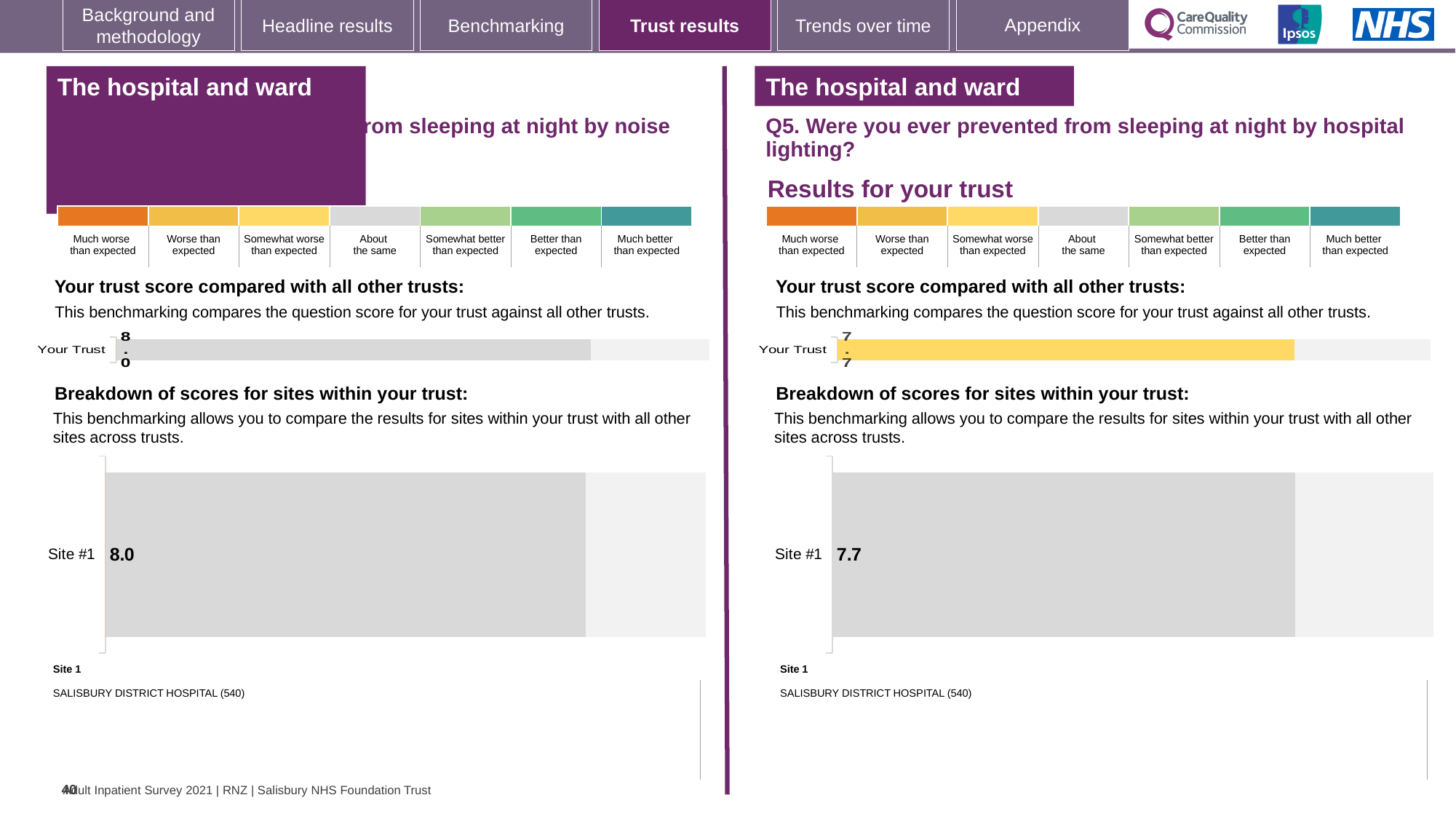
What is the difference between the Site #1 score on the left-hand chart (8.0) and the Site #1 score on the right-hand chart (7.7)? 0.3 Which hospital is listed as Site 1 beneath the site breakdown chart on the right-hand side (Q5, hospital lighting)? SALISBURY DISTRICT HOSPITAL (540) Which is larger: the Your Trust score on the left-hand chart (noise) or the Your Trust score on the right-hand chart (Q5, hospital lighting)? Left-hand chart (noise), 8.0 On the left-hand chart (sleeping at night by noise), what is the score shown for Your Trust? 8.0 On the right-hand site breakdown chart (Q5, hospital lighting), what is the score for Site #1? 7.7 How many sites are shown in the site breakdown chart on the right-hand side (Q5, hospital lighting)? 1 On the left-hand site breakdown chart (sleeping at night by noise), what is the score for Site #1? 8.0 On the right-hand chart (Q5, hospital lighting), what colour is the Your Trust bar? Yellow What kind of chart is used to show the Your Trust score on the right-hand side (Q5, hospital lighting)? Bar chart On the right-hand chart (Q5, hospital lighting), what is the score shown for Your Trust? 7.7 On the right-hand chart (Q5, hospital lighting), which benchmark category does the yellow colour of the Your Trust bar correspond to in the key? Somewhat worse than expected